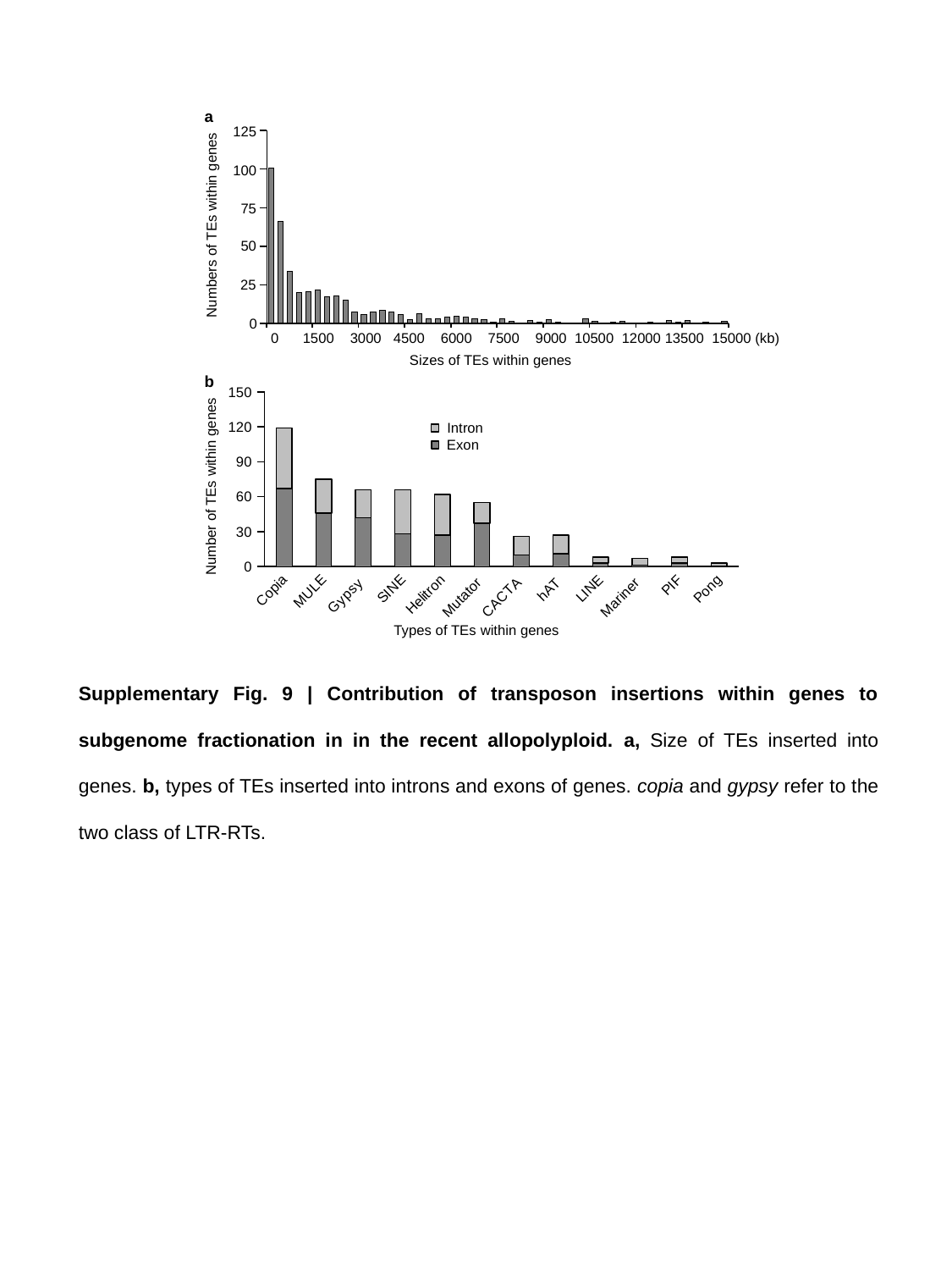
How many series does the legend list in chart b (the bottom chart)? 2 In chart b (the bottom chart), which has a larger Exon value, Gypsy or SINE? Gypsy In chart b (the bottom chart), is the total value for Copia greater or less than 90? greater In chart b (the bottom chart), which type of TE has the lowest total number of TEs within genes? Pong In chart b (the bottom chart), which type of TE has the highest total number of TEs within genes? Copia In chart a (the top chart), is the value of the tallest bar (at size 0) greater or less than 75? greater How many types of TEs are shown on the x axis of chart b (the bottom chart)? 12 What are the two legend entries in chart b (the bottom chart)? Intron and Exon In chart a (the top chart), do the numbers of TEs generally rise or fall as the size of TEs increases along the x axis? fall What kind of chart is chart a (the top chart)? bar chart In chart a (the top chart), is the value of the second bar greater or less than 50? greater